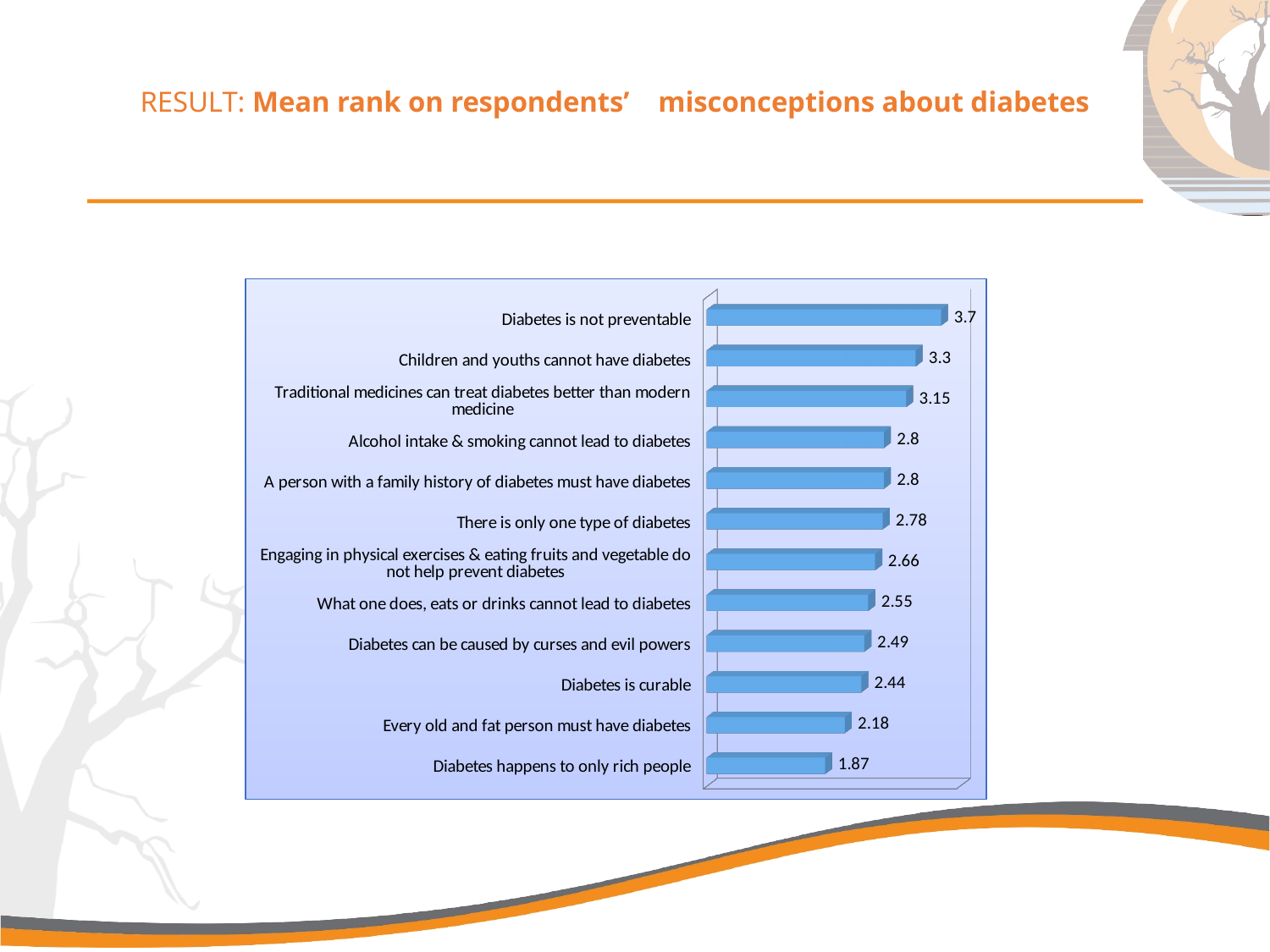
What colour are the bars in the chart? Blue What is the mean rank for "Diabetes happens to only rich people"? 1.87 What is the mean rank for "Diabetes can be caused by curses and evil powers"? 2.49 What is the difference between the mean rank for "Diabetes is not preventable" and "Diabetes happens to only rich people"? 1.83 What is the difference between the mean rank for "Children and youths cannot have diabetes" and "Diabetes is curable"? 0.86 Which has a higher mean rank: "Diabetes is curable" or "Every old and fat person must have diabetes"? Diabetes is curable Which misconception has the highest mean rank? Diabetes is not preventable What is the mean rank for "Diabetes is not preventable"? 3.7 What type of chart is shown on the slide? Bar chart Which misconception has the lowest mean rank? Diabetes happens to only rich people What is the mean rank for "There is only one type of diabetes"? 2.78 How many misconceptions are plotted in the chart? 12